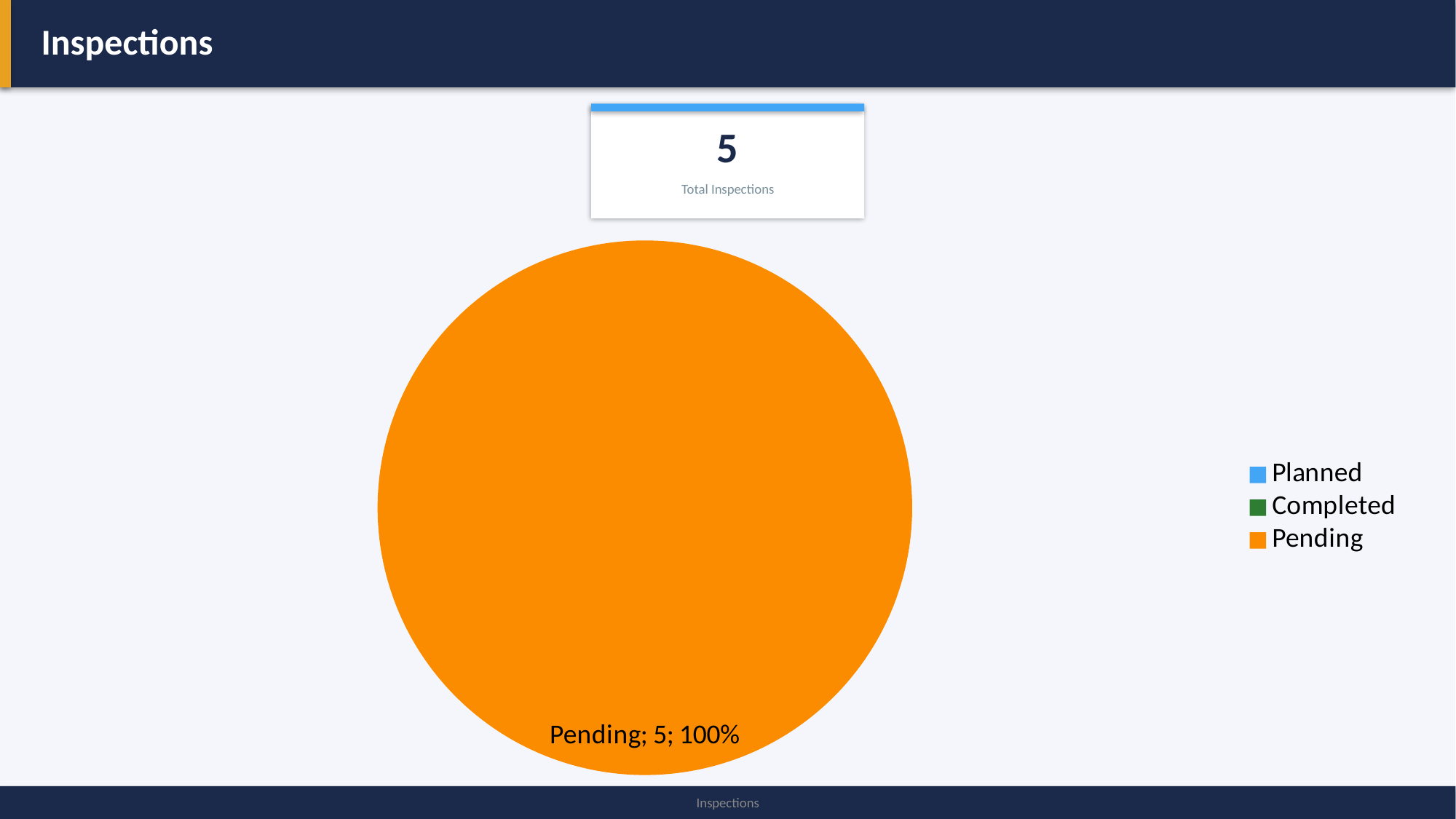
How many entries does the pie chart's legend list? 3 Which category has the largest slice in the pie chart? Pending What is the value shown for the Pending slice of the pie chart? 5 What share of the pie does the Pending slice represent? 100% Which legend entry is shown in green? Completed What colour is the Pending slice in the pie chart? orange Is the value for Pending greater or less than 3? greater What is the Total Inspections figure shown above the pie chart? 5 What kind of chart is shown on the slide? pie chart